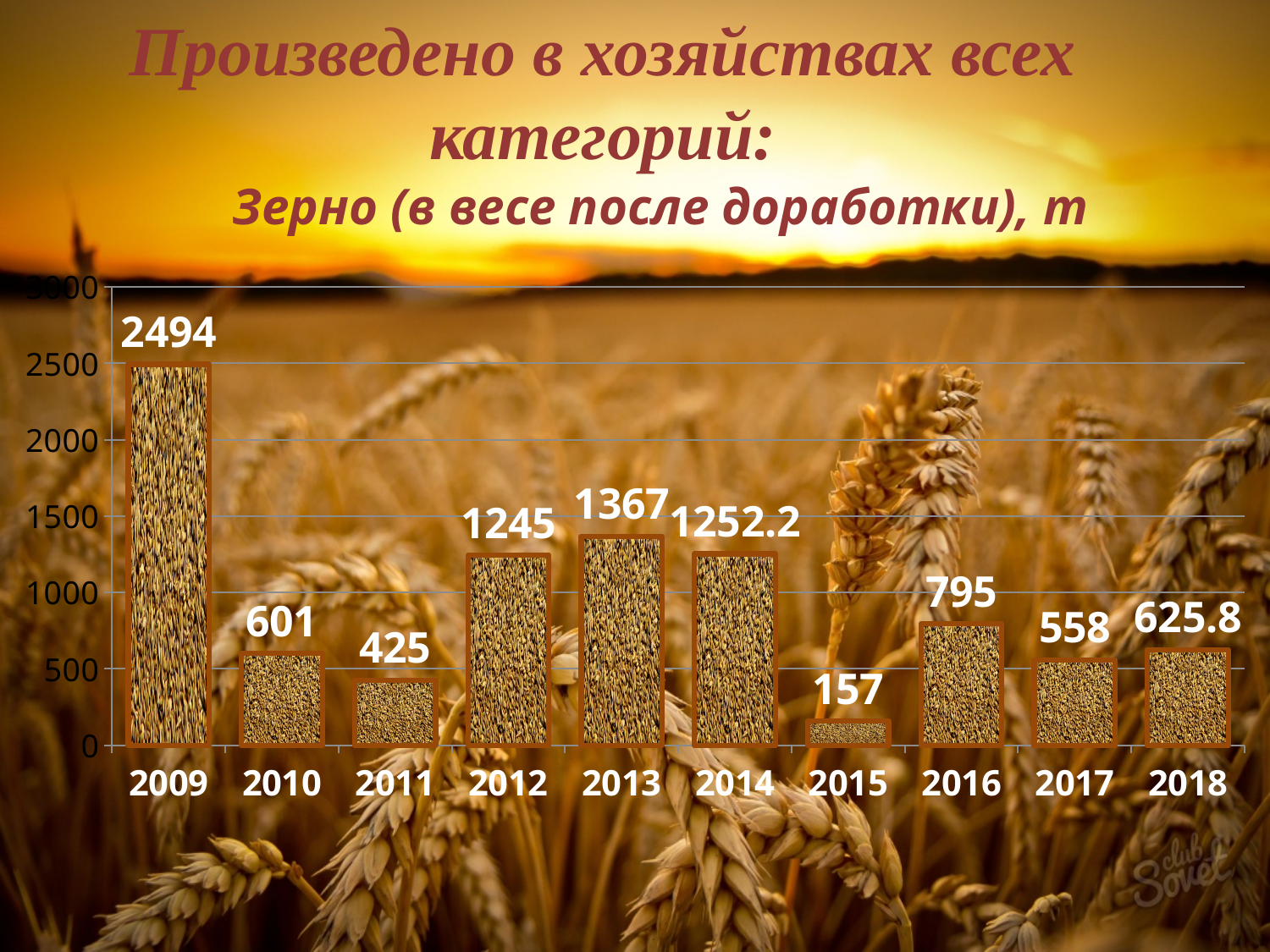
What is the difference between the values for 2013 and 2012? 122 What is the subtitle of the chart describing the measured quantity? Зерно (в весе после доработки), т What is the value for 2009? 2494 What is the difference between the values for 2016 and 2017? 237 Which year has the lowest value? 2015 What is the value for 2018? 625.8 What is the value for 2014? 1252.2 Which year has the highest value? 2009 How many years are shown on the x axis? 10 What kind of chart is shown on the slide? bar chart Is the value for 2016 greater or less than 500? greater Which is larger, the value for 2010 or the value for 2011? 2010